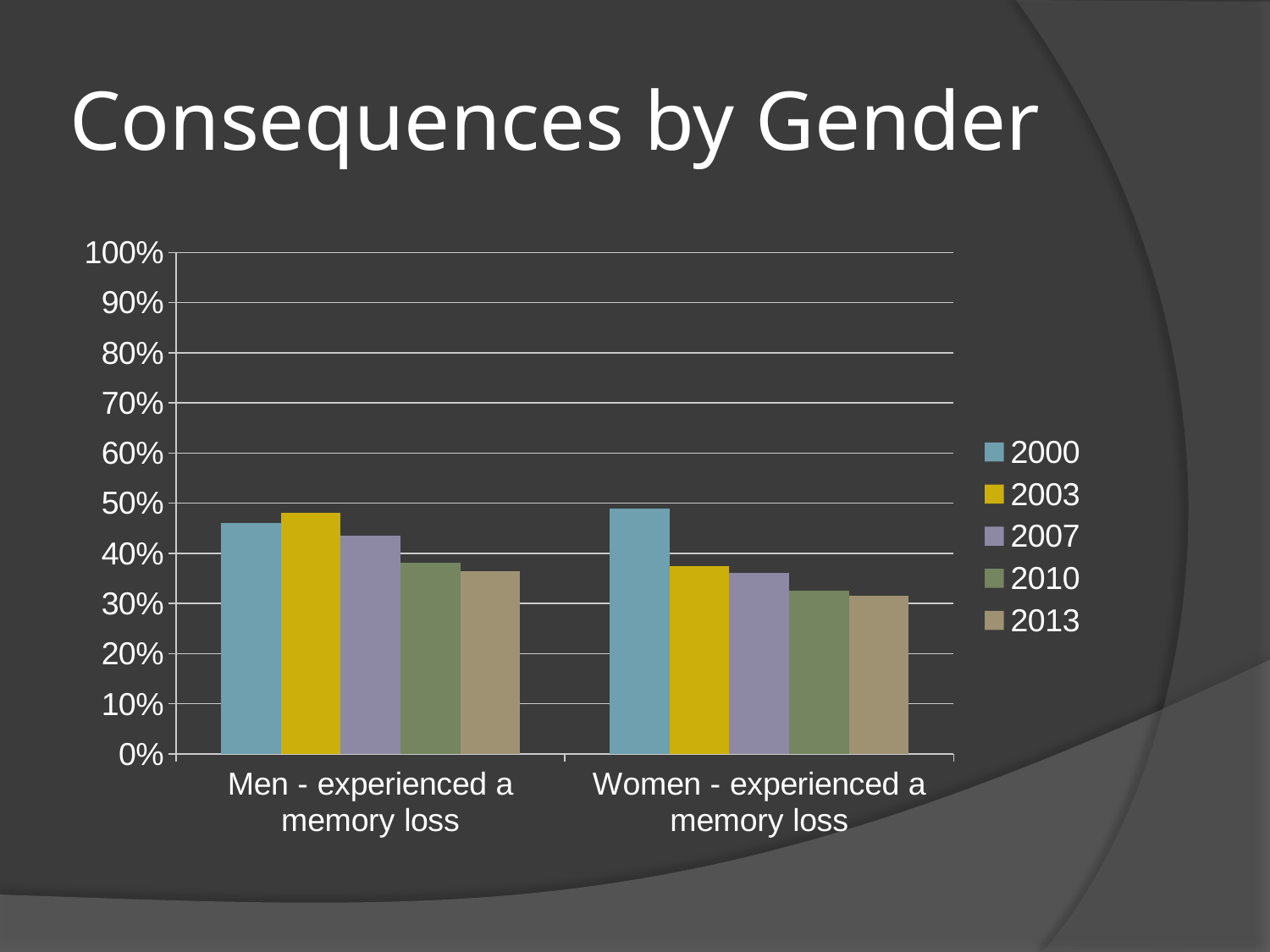
Is the value for Men - experienced a memory loss in 2013 greater or less than 40%? less Which year has the highest value for Women - experienced a memory loss? 2000 For Women - experienced a memory loss, do the values rise or fall from 2000 to 2013? fall Which year has the highest value for Men - experienced a memory loss? 2003 Which is larger in 2013: the value for Men - experienced a memory loss or for Women - experienced a memory loss? Men - experienced a memory loss What is the title of the slide containing the chart? Consequences by Gender Which is larger in 2000: the value for Men - experienced a memory loss or for Women - experienced a memory loss? Women - experienced a memory loss Is the value for Women - experienced a memory loss in 2000 greater or less than 40%? greater How many series does the legend list? 5 What kind of chart is shown on the slide? bar chart Is the value for Women - experienced a memory loss in 2010 greater or less than 40%? less How many categories are shown on the x axis? 2